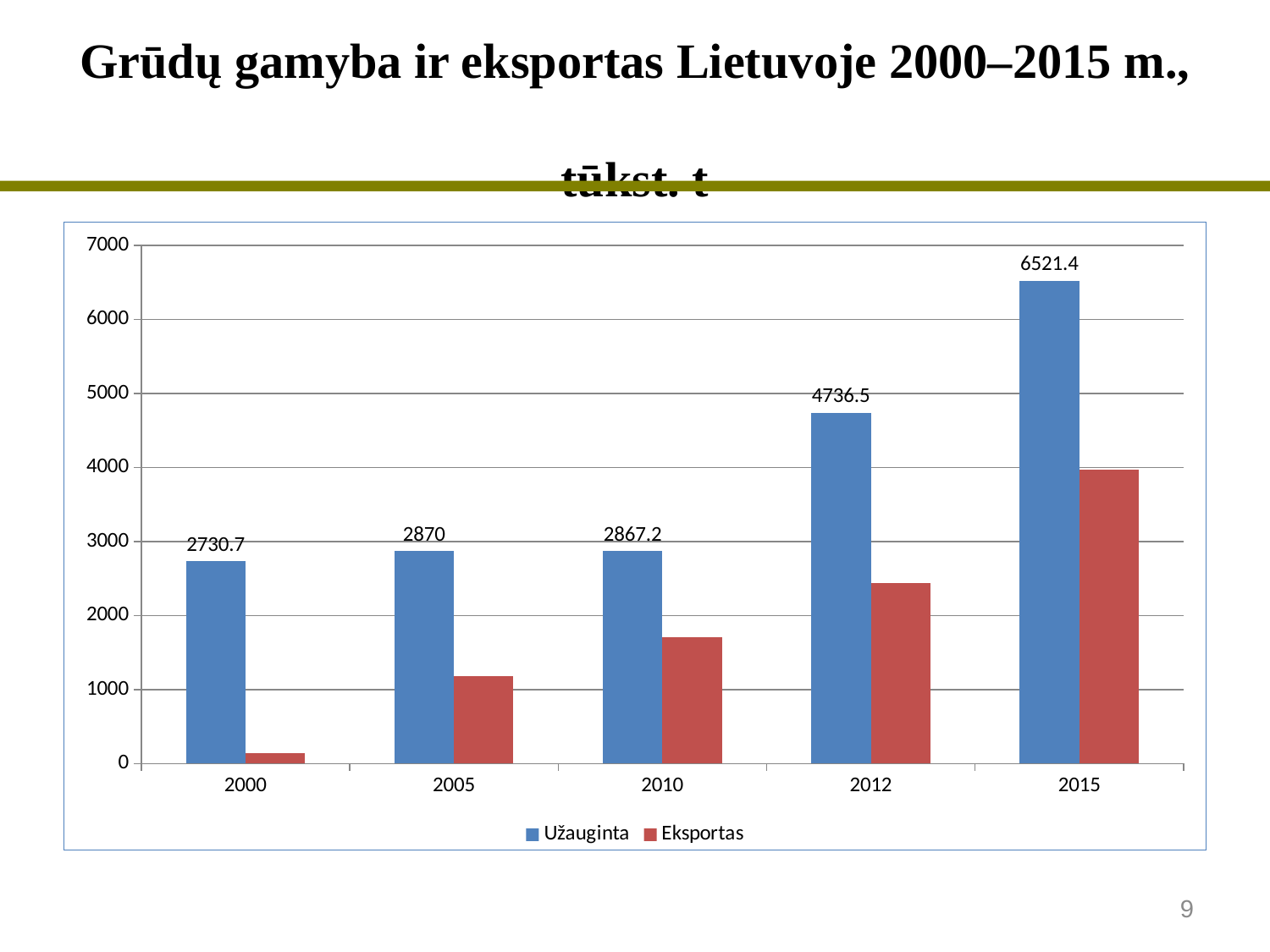
What is the Užauginta value for 2015? 6521.4 What is the Užauginta value for 2000? 2730.7 Which year has the highest Užauginta value? 2015 How many years are shown on the x axis? 5 How many series does the legend list? 2 What is the difference between the Užauginta values for 2015 and 2012? 1784.9 Is the Eksportas value for 2000 greater or less than 1000? less What is the Užauginta value for 2012? 4736.5 Which year has the lowest Užauginta value? 2000 Is the Eksportas value for 2015 greater or less than 3000? greater Do the Eksportas values rise or fall from 2000 to 2015? rise Which is larger, the Užauginta value for 2012 or for 2010? 2012